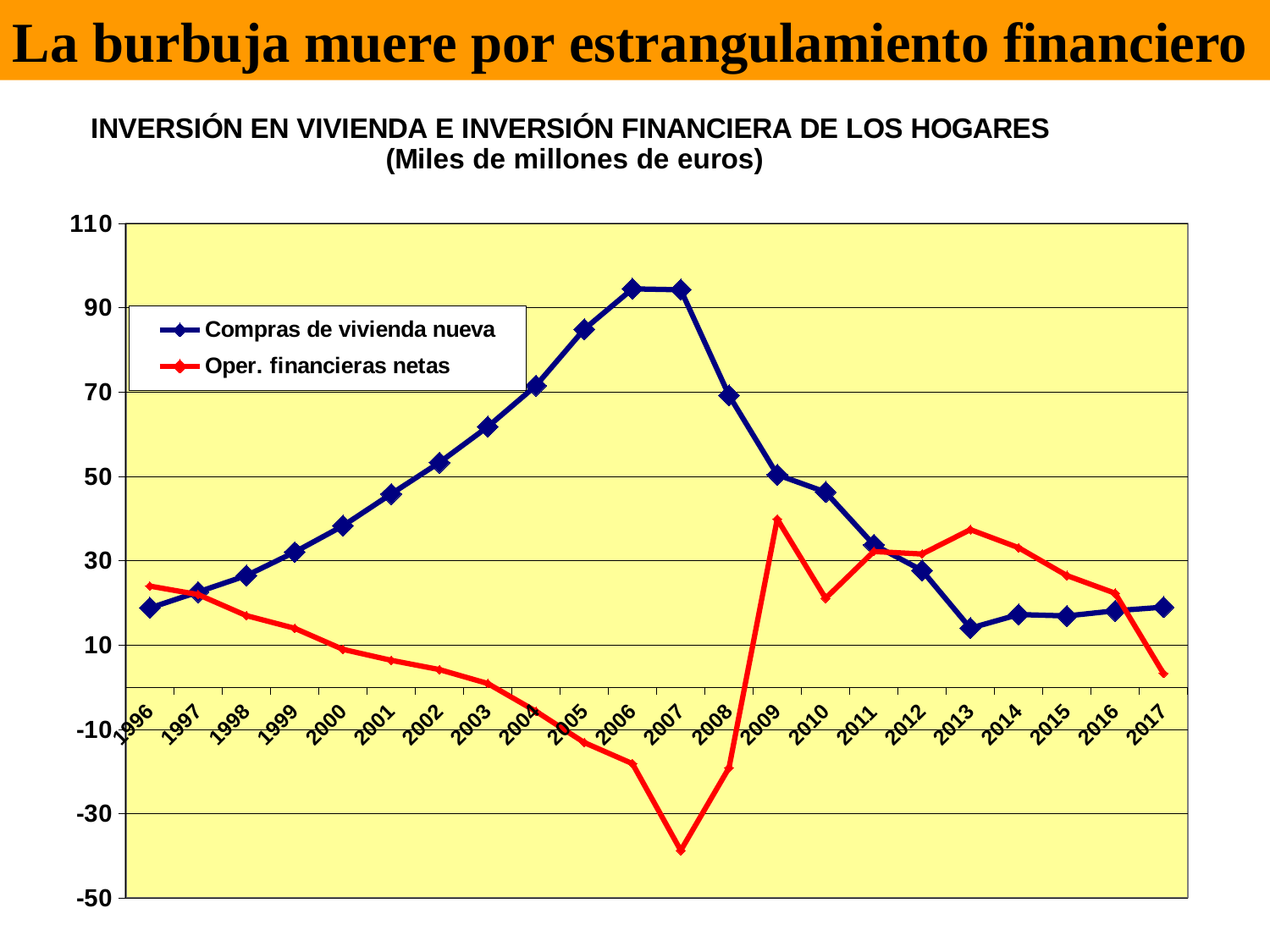
How many years are plotted along the x axis? 22 In which year does the 'Oper. financieras netas' series reach its lowest value? 2007 Does the 'Compras de vivienda nueva' series rise or fall between 1996 and 2006? rise Is the value of 'Oper. financieras netas' in 2007 greater or less than -30? less In 2006, which series has the larger value, 'Compras de vivienda nueva' or 'Oper. financieras netas'? Compras de vivienda nueva What colour is the line for 'Oper. financieras netas'? red Is the value of 'Oper. financieras netas' in 2009 greater or less than 30? greater How many series does the legend list? 2 Is the value of 'Compras de vivienda nueva' in 2006 greater or less than 90? greater In 2013, which series has the larger value, 'Compras de vivienda nueva' or 'Oper. financieras netas'? Oper. financieras netas What kind of chart is shown on the slide? line chart